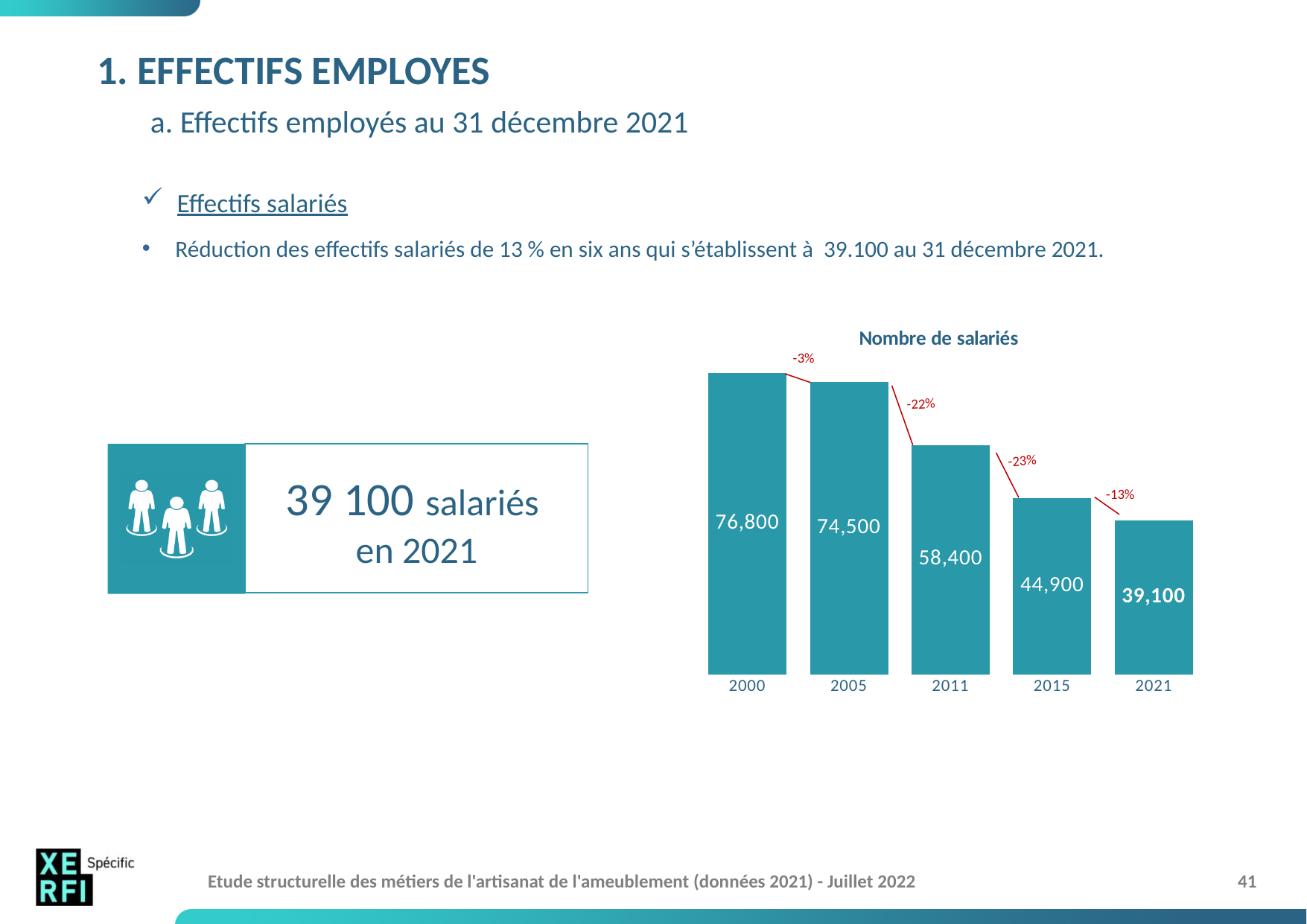
What is the number of salariés shown for 2000? 76,800 What percentage change is annotated between 2011 and 2015? -23% What kind of chart is used to show the number of salariés? Bar chart How many years are shown on the x axis of the chart? 5 What is the difference between the number of salariés in 2005 and in 2011? 16,100 Which year has the highest number of salariés? 2000 What is the difference between the number of salariés in 2000 and in 2021? 37,700 Which year has more salariés, 2015 or 2011? 2011 Which year has the lowest number of salariés? 2021 What is the number of salariés shown for 2011? 58,400 What is the number of salariés shown for 2021? 39,100 Do the values rise or fall from 2000 to 2021? Fall